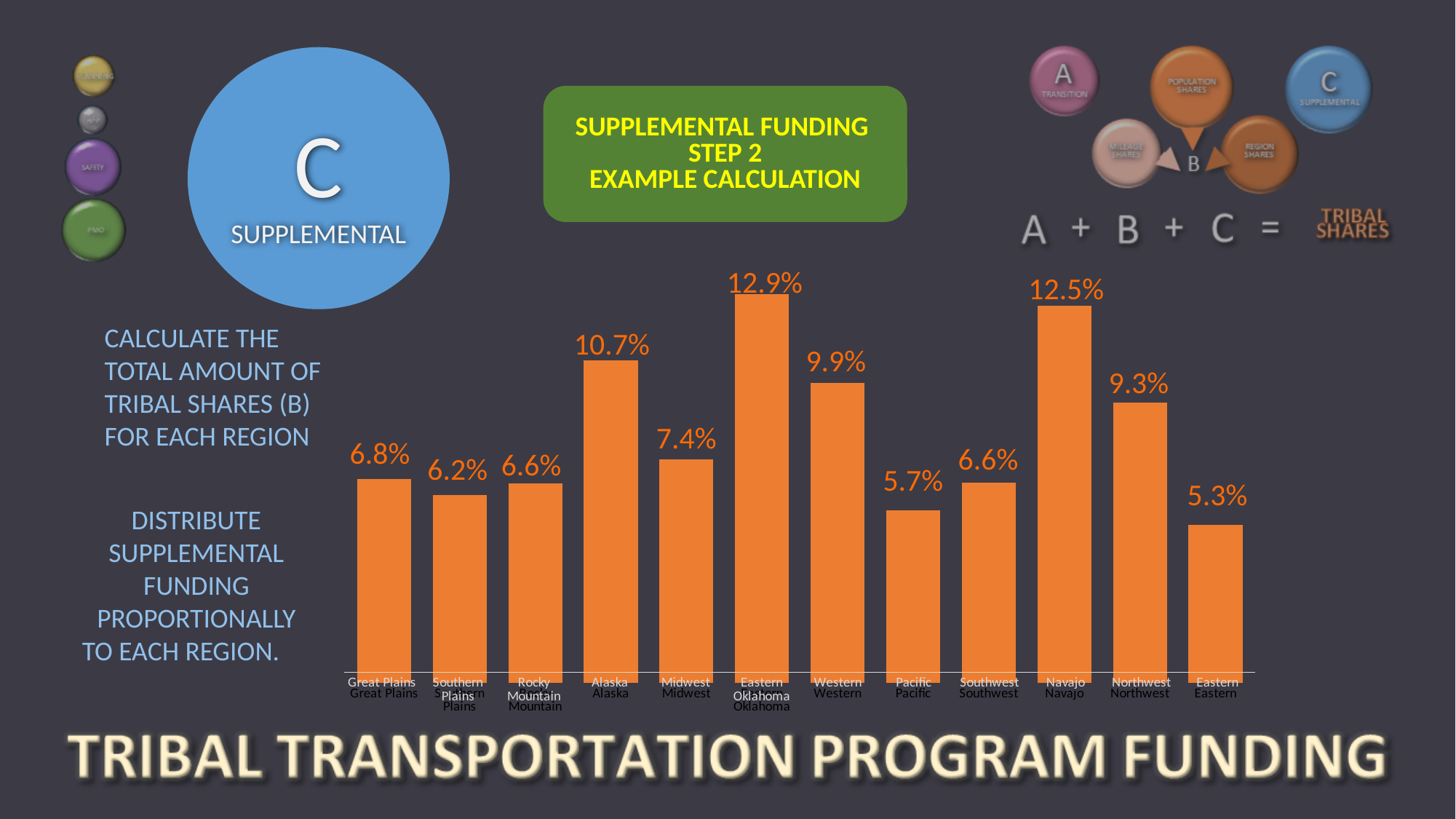
What is the difference between the values for Alaska and Midwest? 3.3% How many regions are shown in the chart? 12 What is the value for Pacific? 5.7% What kind of chart is shown on the slide? Bar chart What is the difference between the values for Eastern Oklahoma and Navajo? 0.4% Which is larger, the value for Western or the value for Northwest? Western What is the value for Alaska? 10.7% Which region has the highest value? Eastern Oklahoma Which region has the lowest value? Eastern What is the value for Eastern Oklahoma? 12.9% What is the value for Navajo? 12.5% What colour are the bars in the chart? Orange